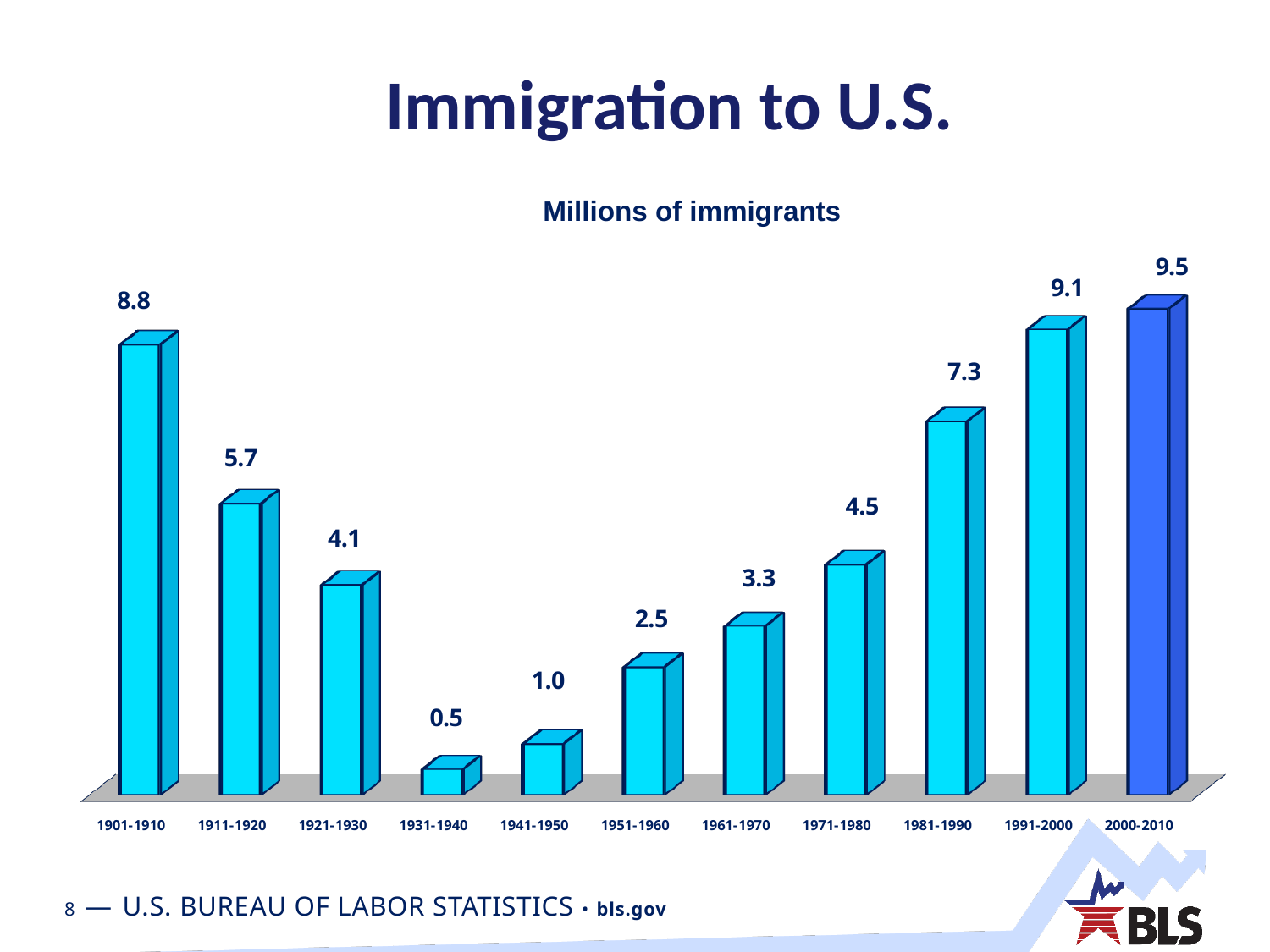
What is the value for 1901-1910? 8.8 What is the value for 1931-1940? 0.5 Which decade has the lowest value? 1931-1940 What is the difference between the values for 1901-1910 and 1911-1920? 3.1 How many decades are shown on the chart? 11 Do the values rise or fall from 1931-1940 to 2000-2010? rise What is the chart's subtitle describing the units? Millions of immigrants What is the difference between the values for 2000-2010 and 1991-2000? 0.4 What is the value for 1981-1990? 7.3 What kind of chart is this? bar chart Which is larger, the value for 1921-1930 or the value for 1971-1980? 1971-1980 Which decade has the highest value? 2000-2010